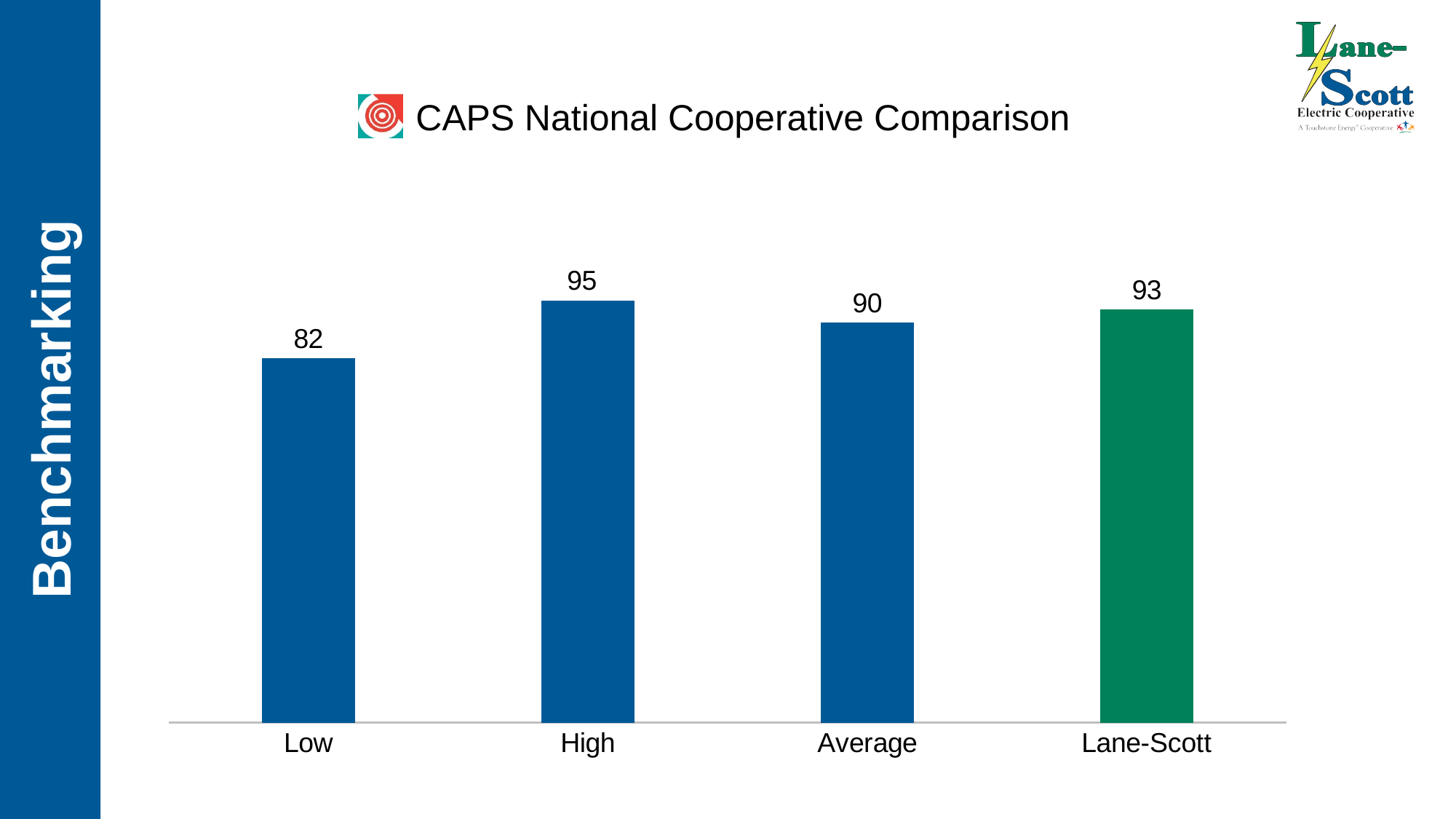
Which category has the highest value? High What is the value for Average? 90 How much higher is Lane-Scott's value than the Average value? 3 What kind of chart is shown on the slide? Bar chart What is the title of the chart? CAPS National Cooperative Comparison What is the value for Low? 82 Which is larger, the value for Lane-Scott or the value for Average? Lane-Scott What is the value for Lane-Scott? 93 What is the difference between the High value and the Low value? 13 What is the value for High? 95 Which category has the lowest value? Low How many categories are shown on the chart? 4